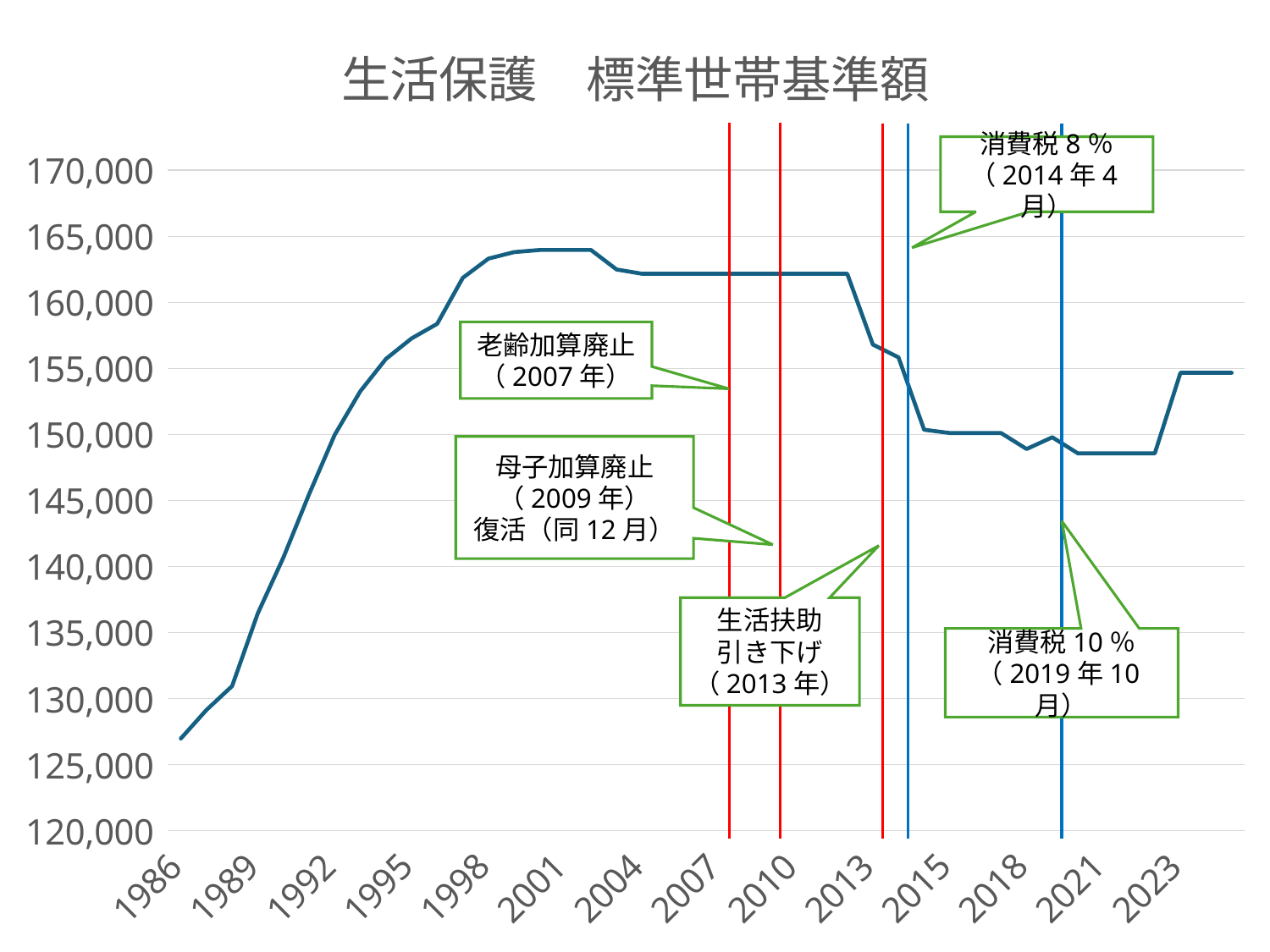
According to the annotation, in which year and month was the consumption tax raised to 10%? 2019年10月 Which is larger, the value for 2001 or the value for 2021? 2001 What is the title of the chart? 生活保護 標準世帯基準額 Is the value for 2001 greater or less than 160,000? greater Is the value for 2021 greater or less than 150,000? less Does the line rise or fall from 1986 to 2001? rises What kind of chart is shown on the slide? line chart Is the value for 2010 greater or less than 160,000? greater Does the line rise or fall from 2013 to 2021? falls